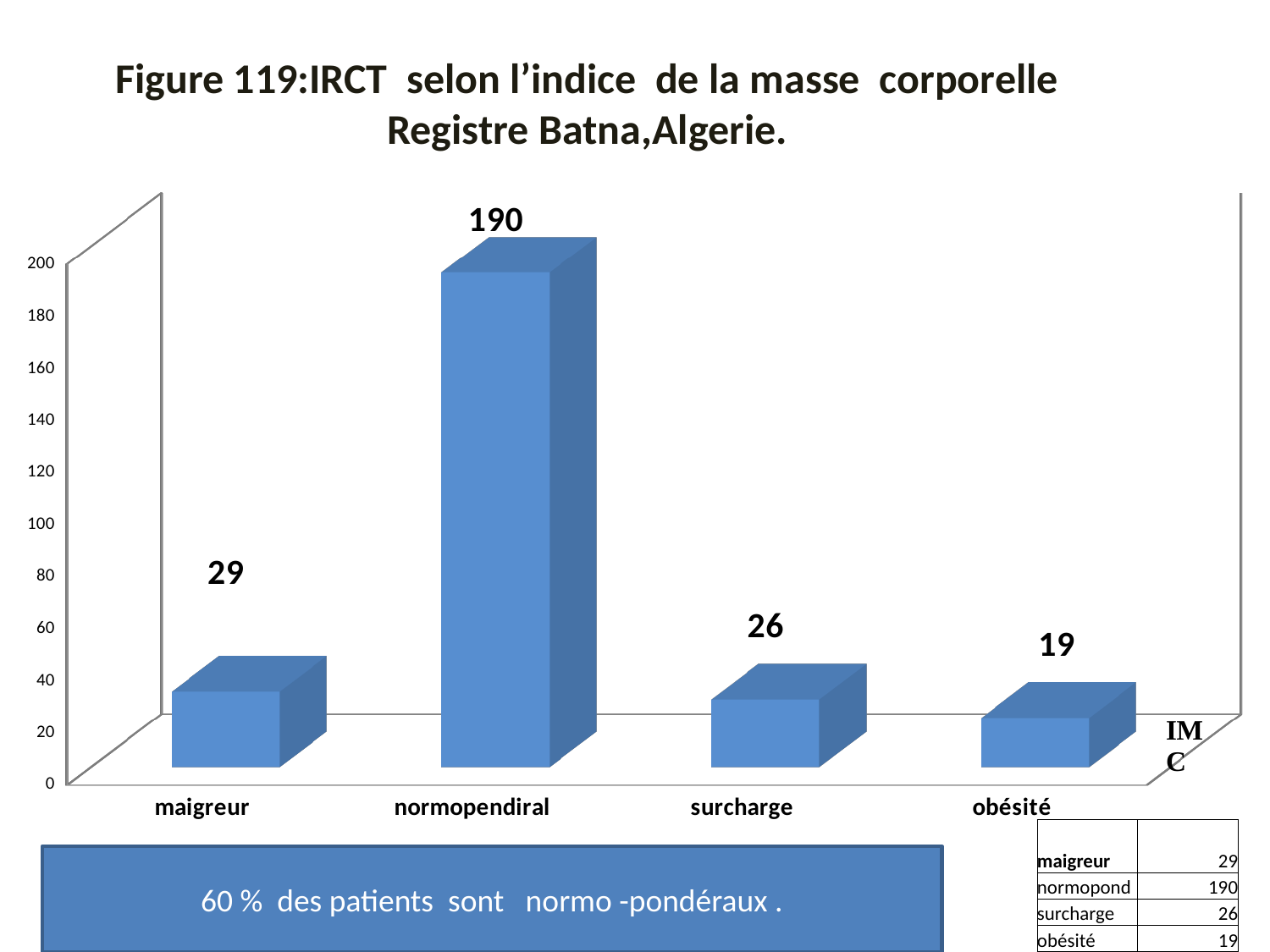
What is the value for surcharge? 26 What is the value for normopendiral? 190 What is the title of the chart? Figure 119:IRCT selon l'indice de la masse corporelle Registre Batna,Algerie. What is the difference between the values for surcharge and obésité? 7 What kind of chart is shown on the slide? bar chart Which category has the lowest value? obésité What is the value for maigreur? 29 Which category has the highest value? normopendiral What is the value for obésité? 19 Which is larger, the value for maigreur or the value for surcharge? maigreur How many categories are shown on the x axis? 4 What is the difference between the values for normopendiral and maigreur? 161